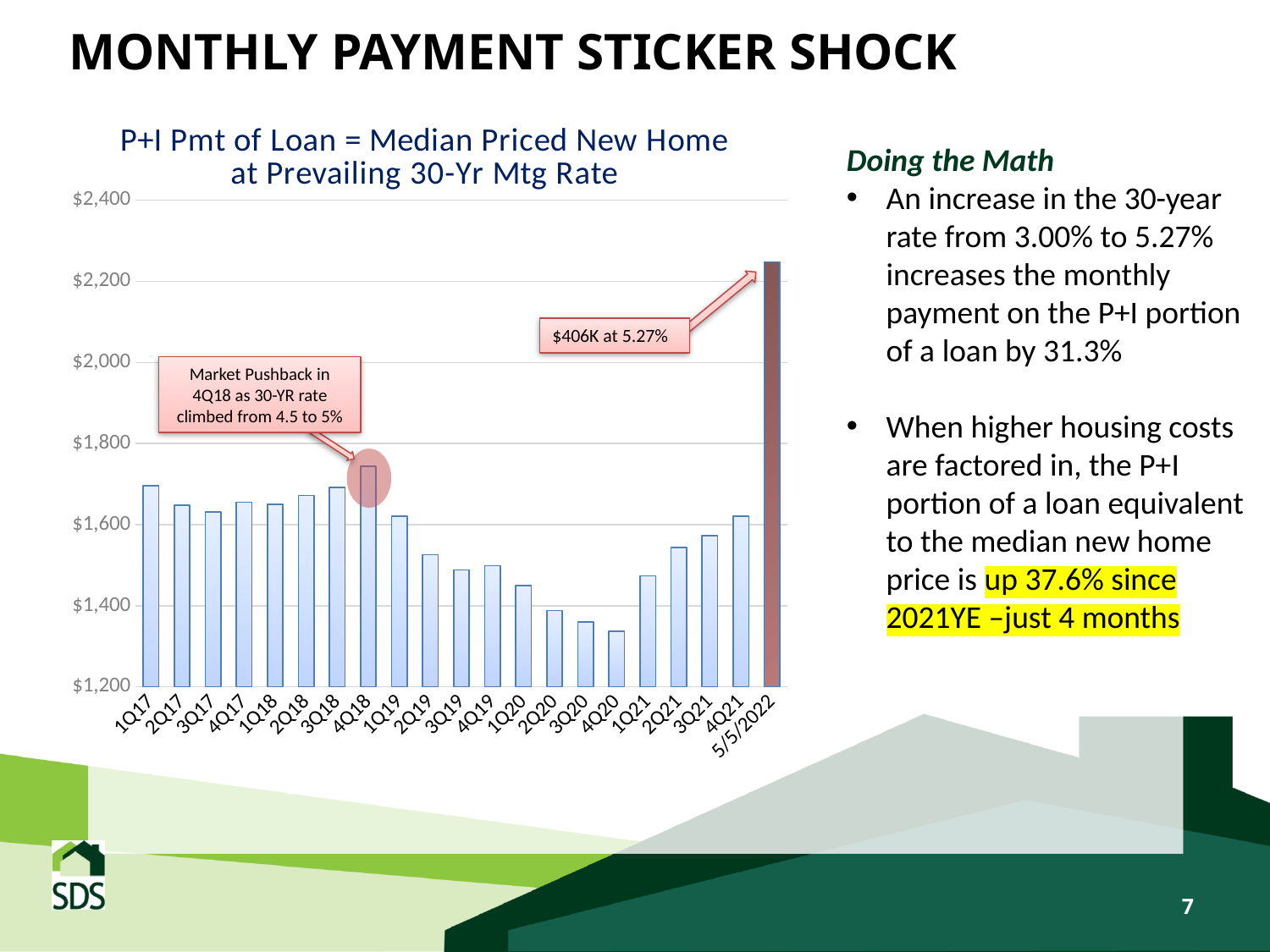
How many bars (time periods) are plotted in the chart? 21 What kind of chart is shown on the slide? Bar chart Is the value for 2Q19 greater or less than $1,600? less Which period has the highest P+I payment in the chart? 5/5/2022 Is the value for 4Q20 greater or less than $1,400? less Do the values rise or fall from 1Q19 to 4Q20? fall What does the callout pointing to the 5/5/2022 bar say? $406K at 5.27% What is the title of the chart? P+I Pmt of Loan = Median Priced New Home at Prevailing 30-Yr Mtg Rate Which is larger, the value for 4Q18 or the value for 1Q19? 4Q18 Which is larger, the value for 1Q17 or the value for 4Q20? 1Q17 Is the value for 5/5/2022 greater or less than $2,200? greater